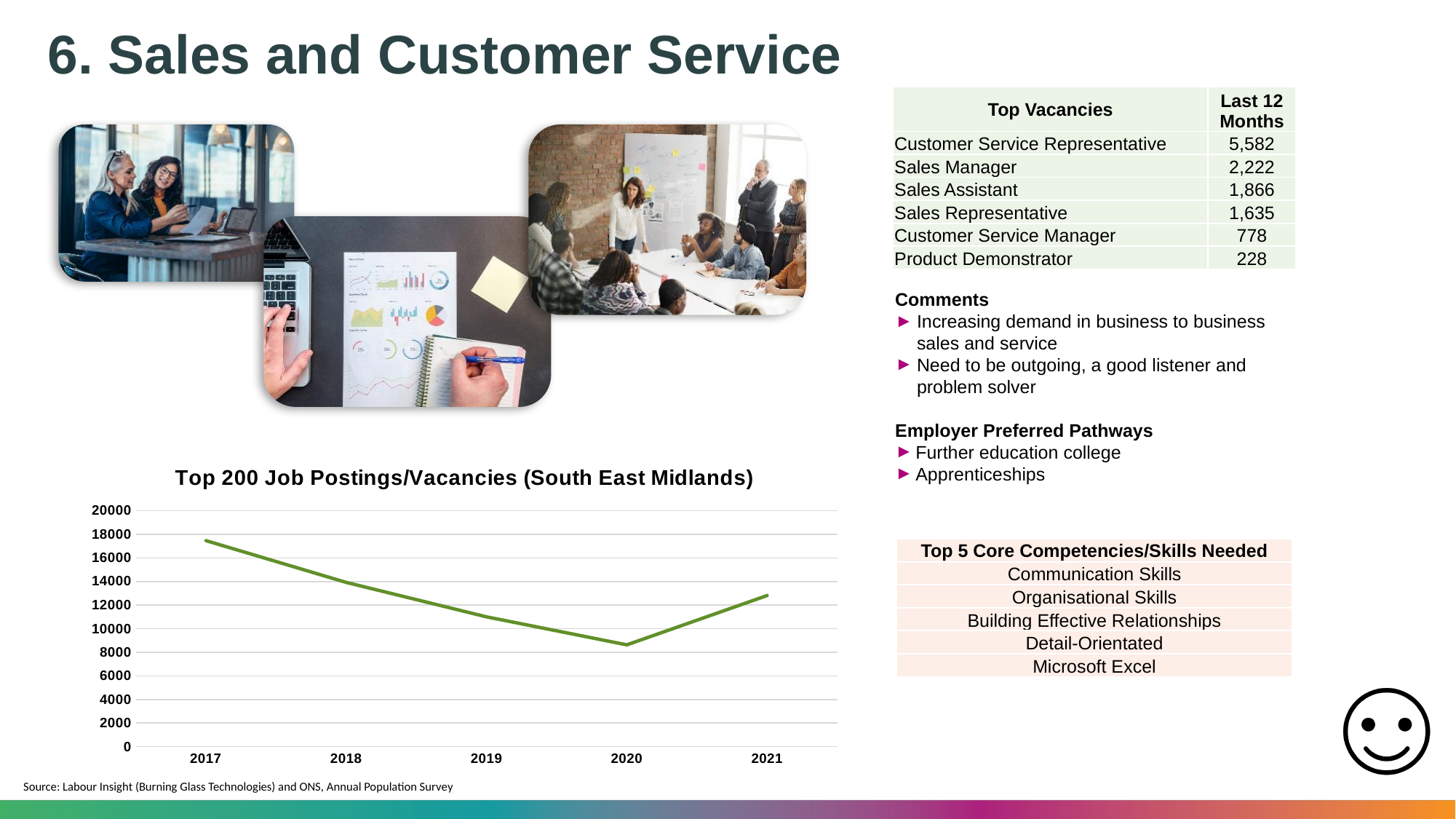
What is the title of the chart? Top 200 Job Postings/Vacancies (South East Midlands) How many years are plotted on the x axis of the chart? 5 Which year has the lowest value in the chart? 2020 What kind of chart is shown on the slide? line chart Do the values rise or fall from 2017 to 2020? fall What is the maximum value shown on the y axis of the chart? 20000 Which year has the highest value in the chart? 2017 Which is larger, the value for 2018 or the value for 2021? 2018 Is the value for 2021 greater or less than 12000? greater Is the value for 2020 greater or less than 10000? less Is the value for 2017 greater or less than 16000? greater